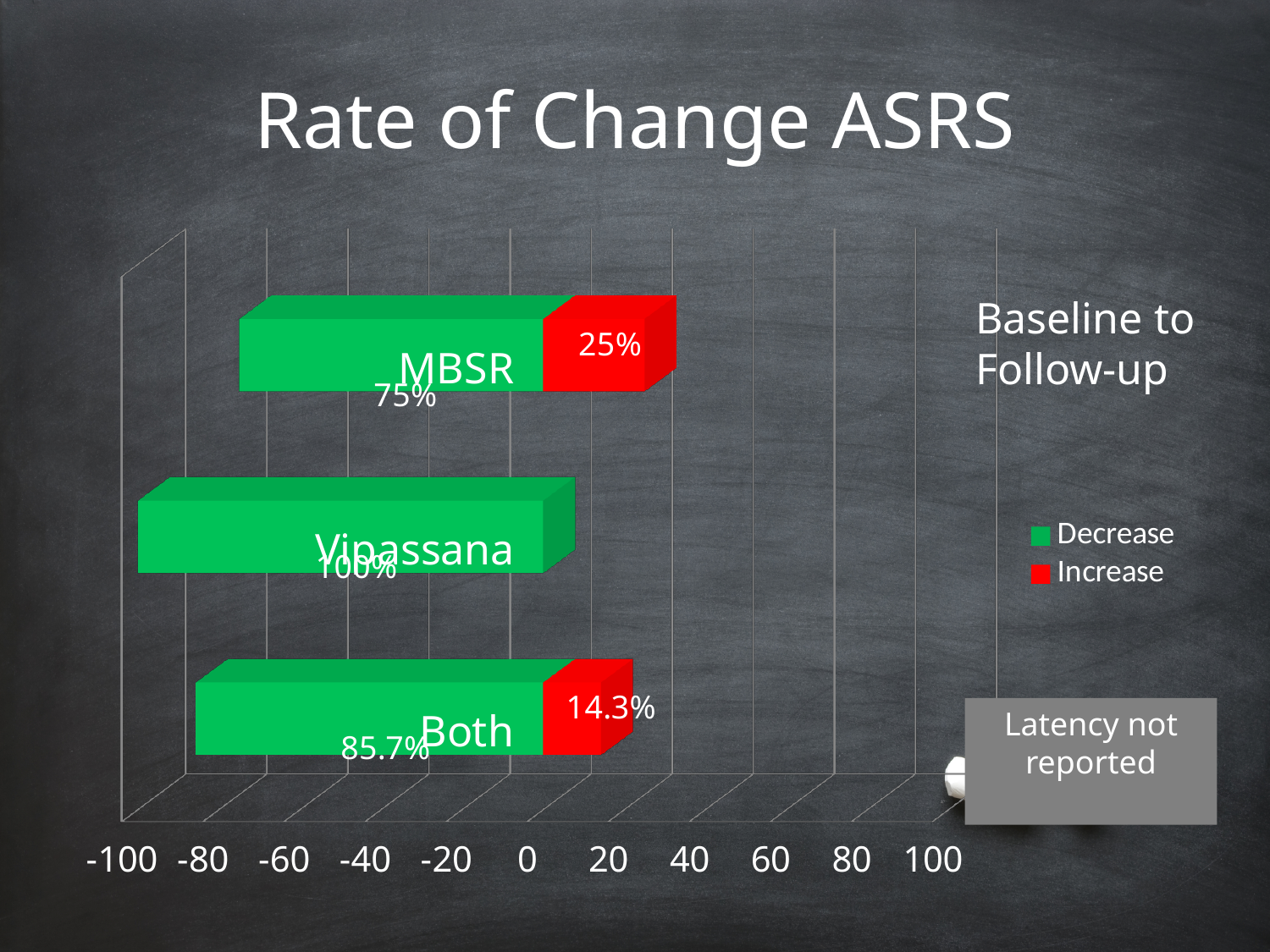
What is the difference between the Increase values for MBSR and Both? 10.7 percentage points How many categories are shown in the chart? 3 What is the Decrease value for Vipassana? 100% What kind of chart is shown on the slide? Bar chart What is the Increase value for Both? 14.3% Which has a larger Increase value, MBSR or Both? MBSR What is the Decrease value for Both? 85.7% Which category has the highest Decrease value? Vipassana What is the Increase value for MBSR? 25% What is the Decrease value for MBSR? 75% Which category has the lowest Decrease value? MBSR How many series does the legend list? 2